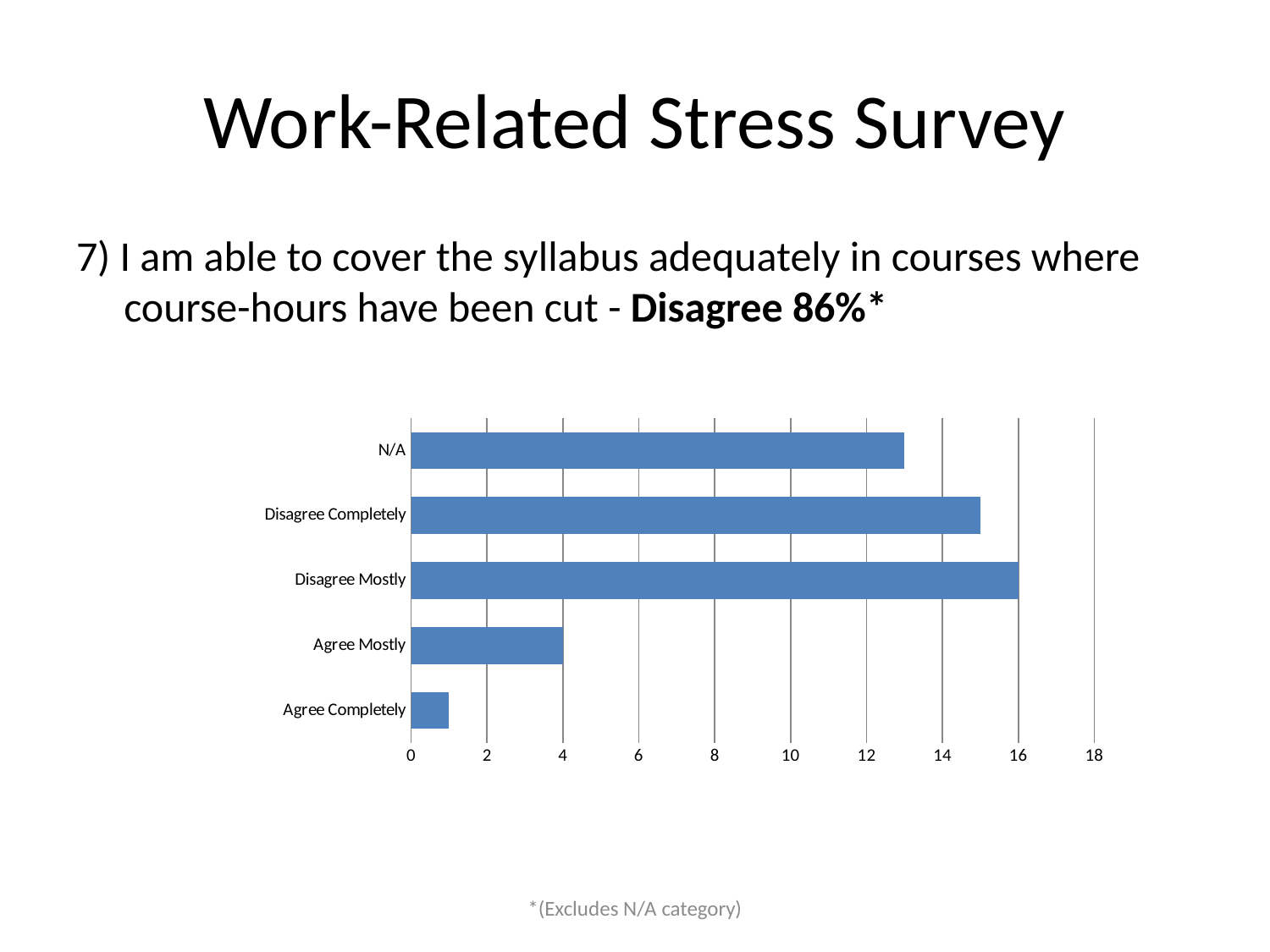
Is the value for Disagree Completely greater or less than 14? greater How many categories are plotted in the chart? 5 Which category has the lowest value? Agree Completely Which is larger, the value for Disagree Completely or the value for N/A? Disagree Completely Is the value for N/A greater or less than 12? greater What is the highest value shown on the horizontal axis? 18 What is the value for Agree Mostly? 4 Which category has the highest value? Disagree Mostly What is the value for Disagree Mostly? 16 What type of chart is shown on the slide? bar chart Is the value for Agree Completely greater or less than 2? less What is the difference between the values for Disagree Mostly and Agree Mostly? 12